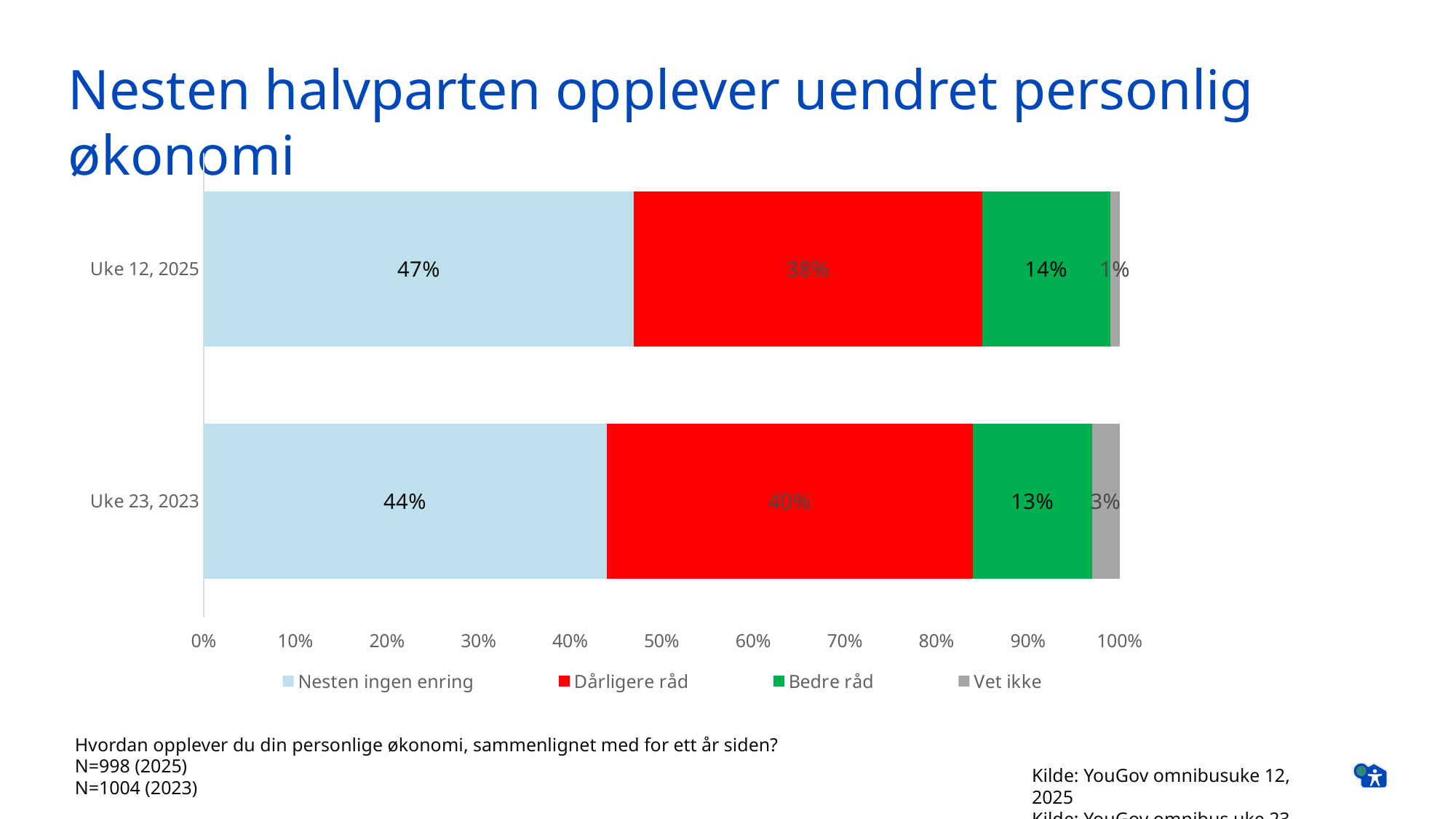
What is the difference between the "Dårligere råd" values for Uke 23, 2023 and Uke 12, 2025? 2% What is the value for "Bedre råd" in Uke 12, 2025? 14% What colour represents "Dårligere råd" in the chart? Red How many series does the legend list? 4 What is the value for "Nesten ingen enring" in Uke 12, 2025? 47% Which series has the highest value in the Uke 23, 2023 bar? Nesten ingen enring What is the value for "Vet ikke" in Uke 23, 2023? 3% What kind of chart is shown on the slide? Stacked bar chart What is the value for "Dårligere råd" in Uke 23, 2023? 40% Which category has the higher value for "Nesten ingen enring", Uke 12, 2025 or Uke 23, 2023? Uke 12, 2025 Which series has the lowest value in the Uke 12, 2025 bar? Vet ikke How many categories (bars) are shown on the chart? 2